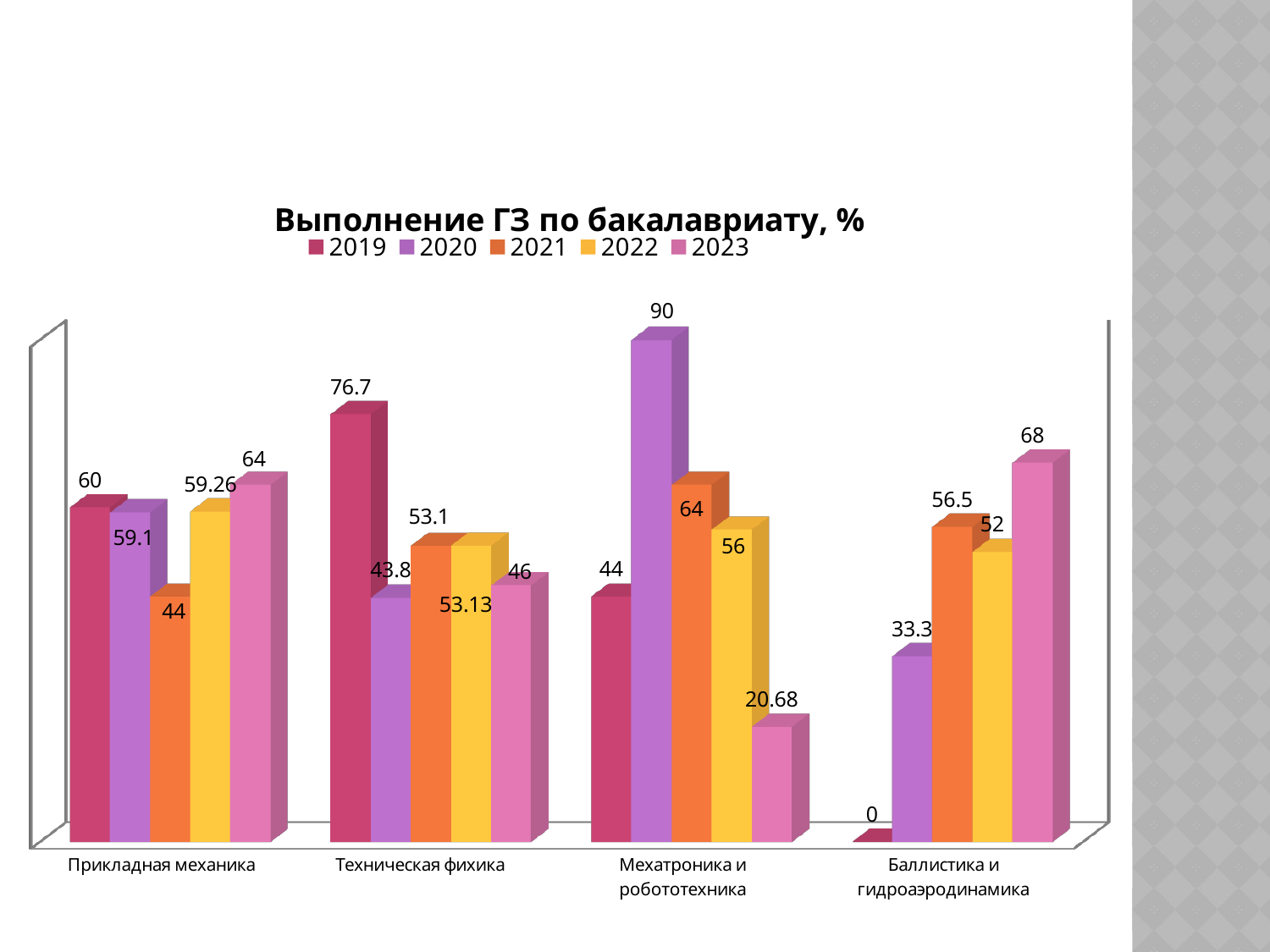
What is the value for 2022 in the Прикладная механика category? 59.26 What kind of chart is shown on the slide? Bar chart Which is larger in the Прикладная механика category: the value for 2019 or the value for 2021? 2019 How many categories are shown on the x axis? 4 What is the title of the chart? Выполнение ГЗ по бакалавриату, % Which year has the highest value in the Мехатроника и робототехника category? 2020 What is the value for 2019 in the Техническая фихика category? 76.7 Which year has the lowest value in the Баллистика и гидроаэродинамика category? 2019 What is the value for 2020 in the Мехатроника и робототехника category? 90 What is the value for 2023 in the Баллистика и гидроаэродинамика category? 68 What is the difference between the 2020 and 2023 values in the Мехатроника и робототехника category? 69.32 How many series does the legend list? 5